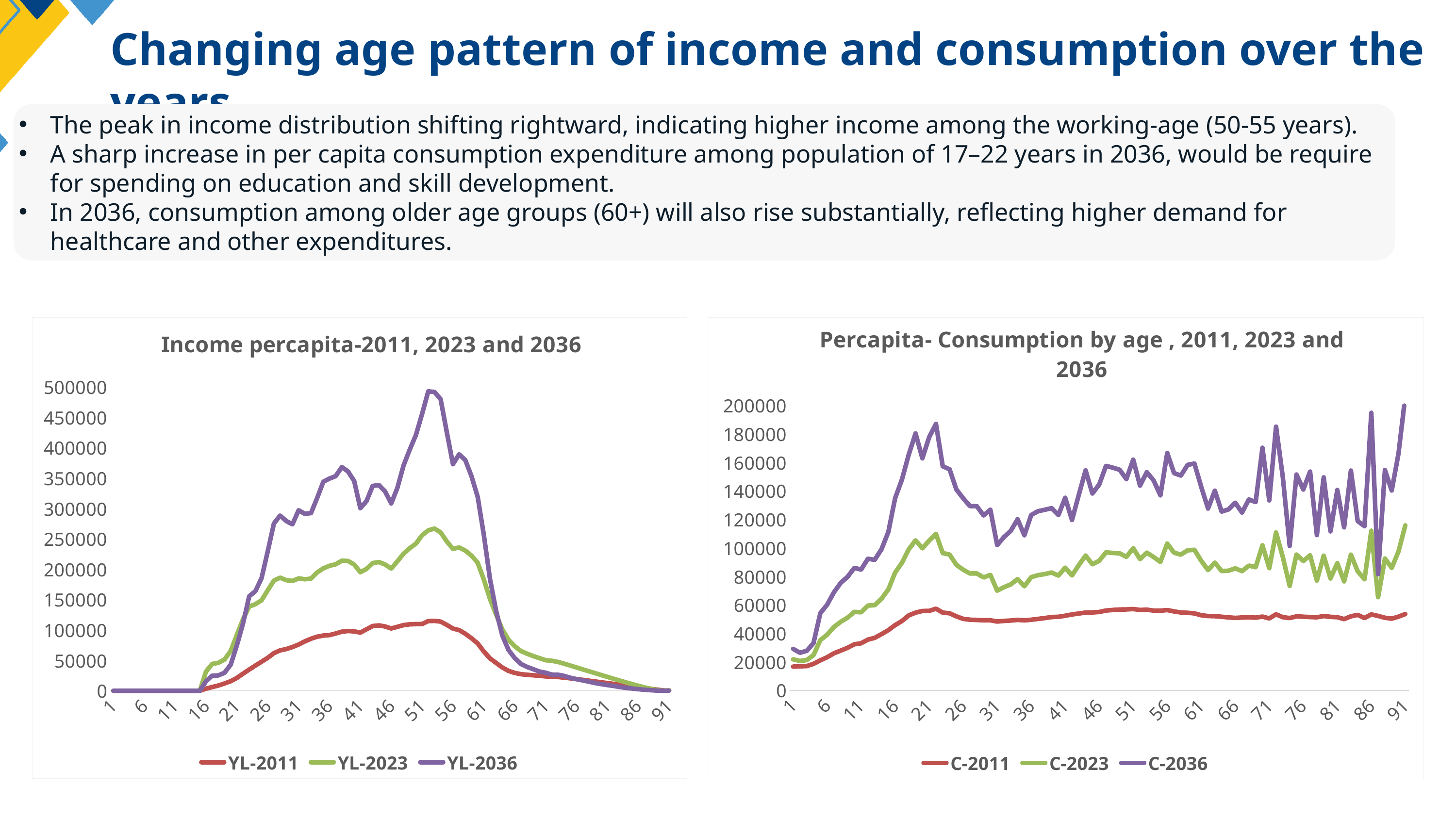
In the 'Income percapita-2011, 2023 and 2036' chart, what is the highest value shown on the vertical axis? 500000 In the 'Income percapita-2011, 2023 and 2036' chart, which series is larger at age 51, YL-2023 or YL-2011? YL-2023 In the 'Income percapita-2011, 2023 and 2036' chart, which series reaches the highest value? YL-2036 In the 'Percapita- Consumption by age' chart, is the value of C-2011 at age 1 greater or less than 40000? less What kind of chart is the 'Income percapita-2011, 2023 and 2036' chart? line chart In the 'Income percapita-2011, 2023 and 2036' chart, is the peak value of YL-2011 greater or less than 150000? less In the 'Percapita- Consumption by age' chart, does the C-2011 line rise or fall between age 1 and age 21? rise How many series does the legend of the 'Income percapita-2011, 2023 and 2036' chart list? 3 In the 'Income percapita-2011, 2023 and 2036' chart, is the peak value of YL-2036 greater or less than 450000? greater What kind of chart is the 'Percapita- Consumption by age , 2011, 2023 and 2036' chart? line chart In the 'Percapita- Consumption by age' chart, which series has the lowest values across the ages? C-2011 In the 'Percapita- Consumption by age' chart, which series does the legend list in purple? C-2036